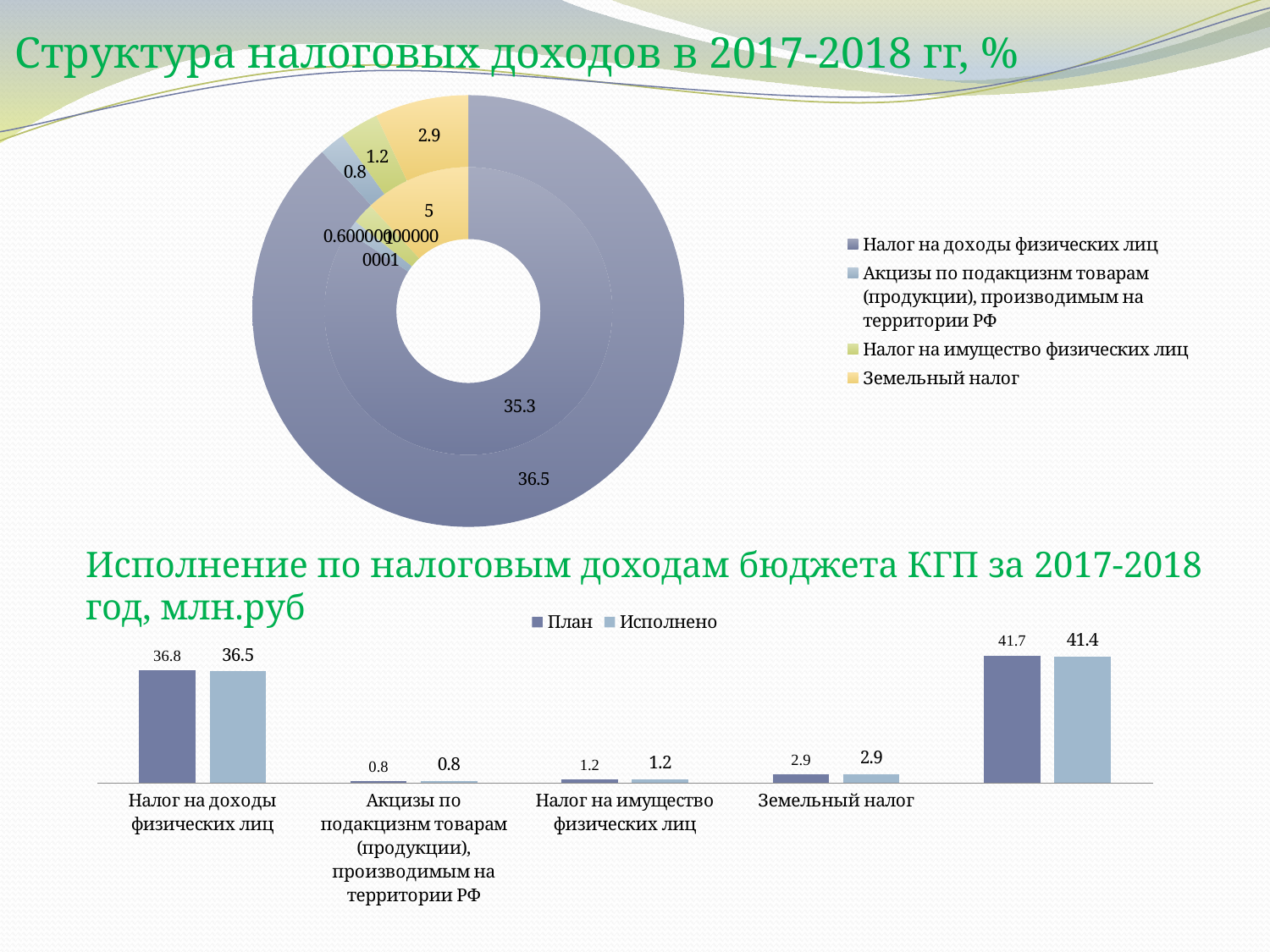
How many categories does the legend of the top doughnut chart list? 4 What kind of chart is the top chart on the slide? Doughnut chart In the bottom bar chart, what is the Исполнено value for Земельный налог? 2.9 In the bottom bar chart, what is the План value for Налог на доходы физических лиц? 36.8 How many series does the legend of the bottom bar chart list? 2 In the top doughnut chart, which category has the largest share? Налог на доходы физических лиц In the bottom bar chart, which labeled category has the lowest План value? Акцизы по подакцизнм товарам (продукции), производимым на территории РФ In the bottom bar chart, what is the План value for Налог на имущество физических лиц? 1.2 In the bottom bar chart, which has the larger План value: Земельный налог or Налог на имущество физических лиц? Земельный налог In the bottom bar chart, what is the Исполнено value for Налог на доходы физических лиц? 36.5 In the bottom bar chart, what is the difference between the План and Исполнено values for Налог на доходы физических лиц? 0.3 What kind of chart is the bottom chart on the slide? Bar chart